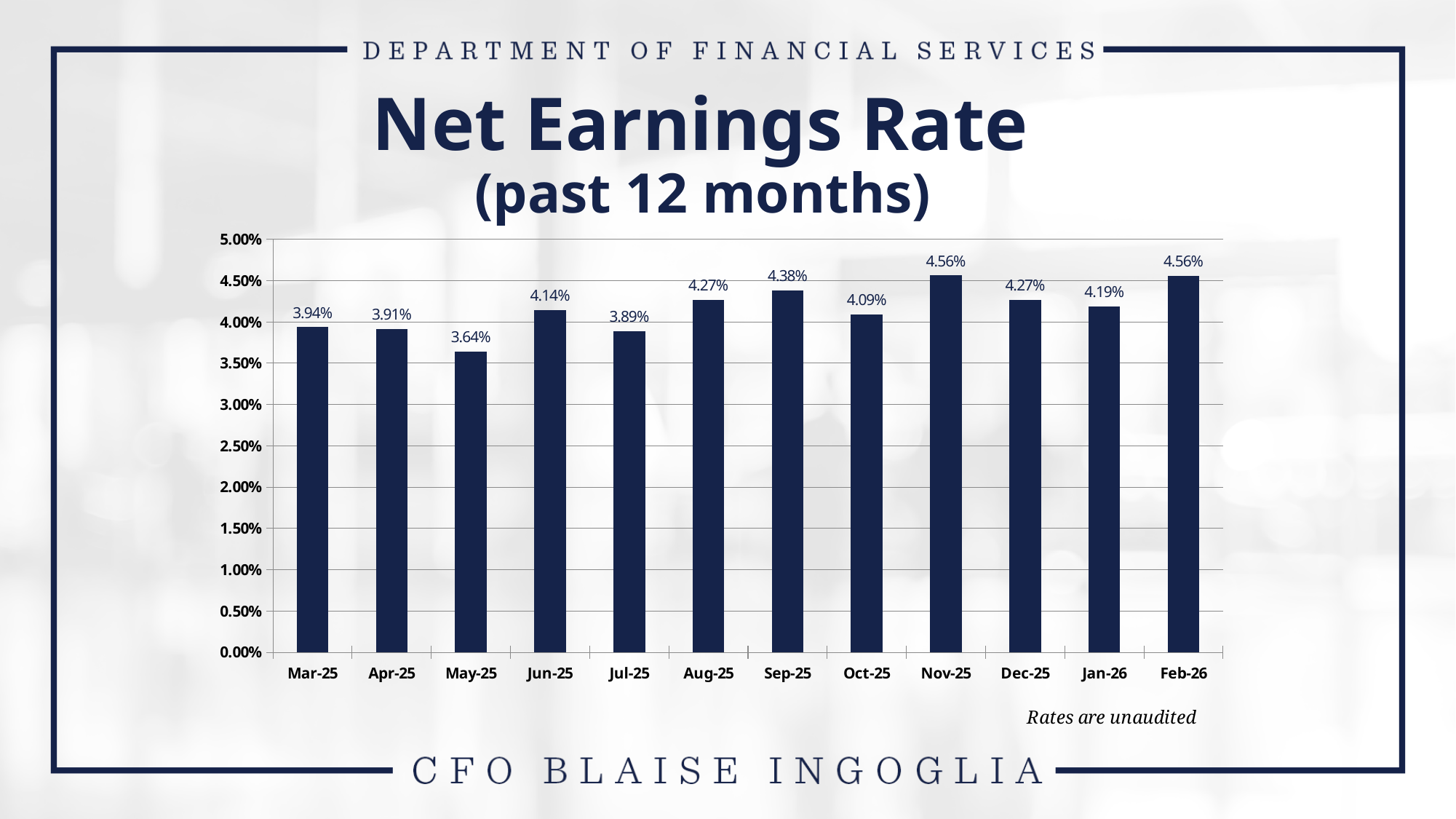
What is the net earnings rate for Jan-26? 4.19% What is the net earnings rate for May-25? 3.64% Which is larger, the net earnings rate for Jun-25 or for Jul-25? Jun-25 What is the difference between the net earnings rate for Sep-25 and for Oct-25? 0.29% Is the net earnings rate for Apr-25 greater or less than 4.00%? less What note appears below the chart about the rates? Rates are unaudited How many months are shown on the x axis of the chart? 12 What kind of chart is used to show the net earnings rate? Bar chart Which two months share the highest net earnings rate of 4.56%? Nov-25 and Feb-26 What is the net earnings rate for Sep-25? 4.38% Which month has the lowest net earnings rate? May-25 What is the difference between the net earnings rate for Feb-26 and for Mar-25? 0.62%